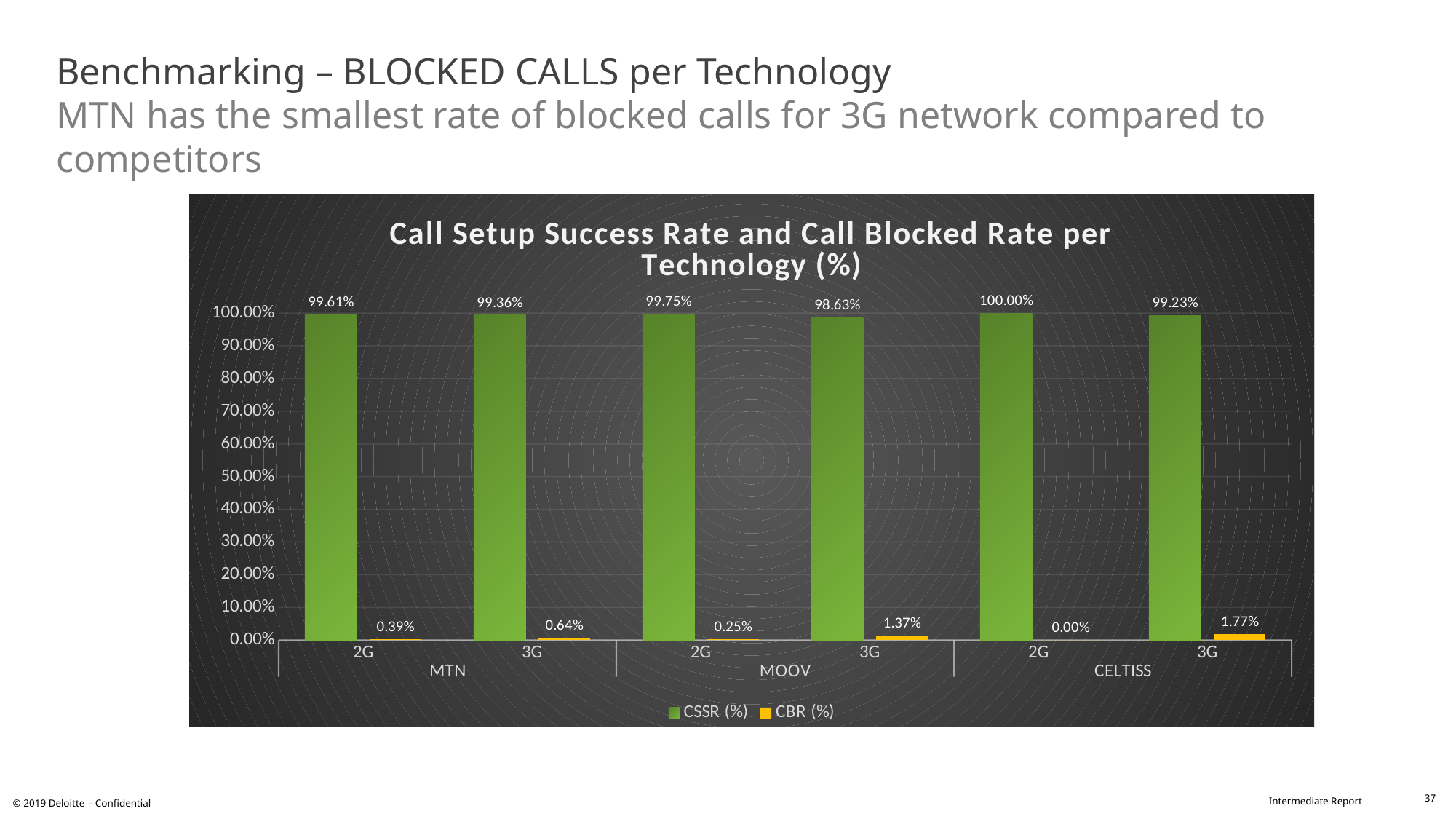
What kind of chart is shown on the slide? Bar chart Which is larger, the CBR (%) for MOOV 3G or the CBR (%) for MTN 3G? MOOV 3G What is the CBR (%) value for CELTISS 3G? 1.77% What is the CSSR (%) value for MTN 2G? 99.61% Which operator and technology has the highest CSSR (%)? CELTISS 2G Which operator and technology has the lowest CBR (%)? CELTISS 2G What is the CSSR (%) value for MOOV 3G? 98.63% How many series does the legend list? 2 What is the CBR (%) value for MOOV 2G? 0.25% What is the title of the chart? Call Setup Success Rate and Call Blocked Rate per Technology (%) What is the difference between the CBR (%) for CELTISS 3G and MTN 3G? 1.13% Which operator and technology has the highest CBR (%)? CELTISS 3G